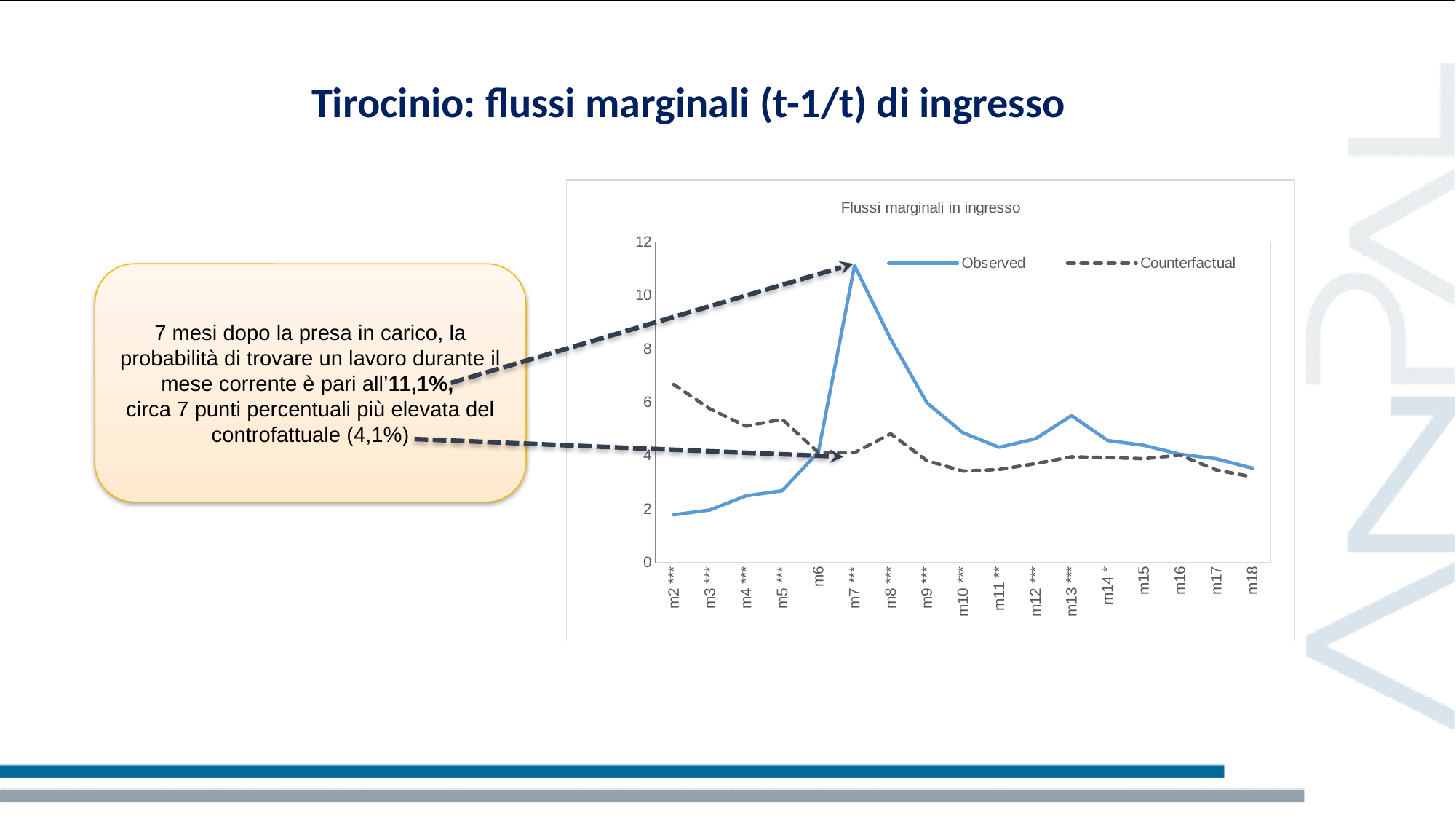
How many series does the chart legend list? 2 Does the Observed series rise or fall from m7 to m18? fall At which month does the Observed series have its lowest value? m2 Is the Observed value at m7 greater or less than 10? greater How many months (points) are shown along the x axis of the chart? 17 What are the two series named in the chart legend? Observed and Counterfactual At which month does the Observed series reach its highest value? m7 At m2, which series has the larger value, Observed or Counterfactual? Counterfactual What kind of chart is shown on the slide? line chart At m7, which series has the larger value, Observed or Counterfactual? Observed At which month does the Counterfactual series reach its highest value? m2 What is the title of the chart? Flussi marginali in ingresso